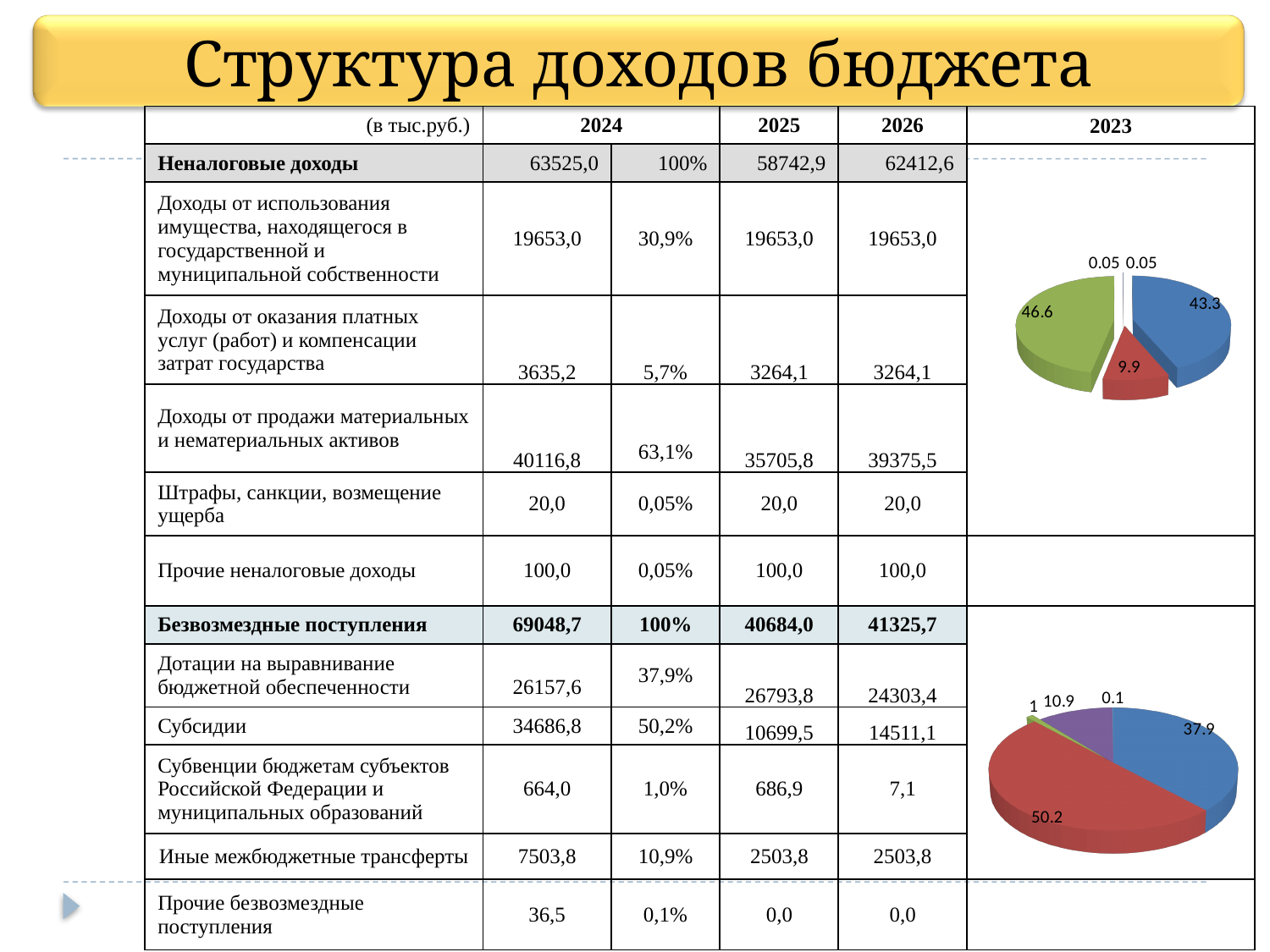
In the lower pie chart, what is the value of the smallest slice? 0.1 In the upper pie chart, what is the value of the largest slice? 46.6 In the upper pie chart, what value is shown on the blue slice? 43.3 In the lower pie chart, what is the difference between the red slice (50.2) and the blue slice (37.9)? 12.3 In the upper pie chart, what is the difference between the green slice (46.6) and the blue slice (43.3)? 3.3 How many slices does the lower pie chart have? 5 How many slices does the upper pie chart have? 5 In the upper pie chart, which is larger, the green slice or the blue slice? green slice In the upper pie chart, what value is shown on the red slice? 9.9 In the lower pie chart, what value is shown on the purple slice? 10.9 What type of chart is the upper chart on the right side of the slide? pie chart In the lower pie chart, what is the value of the largest slice? 50.2